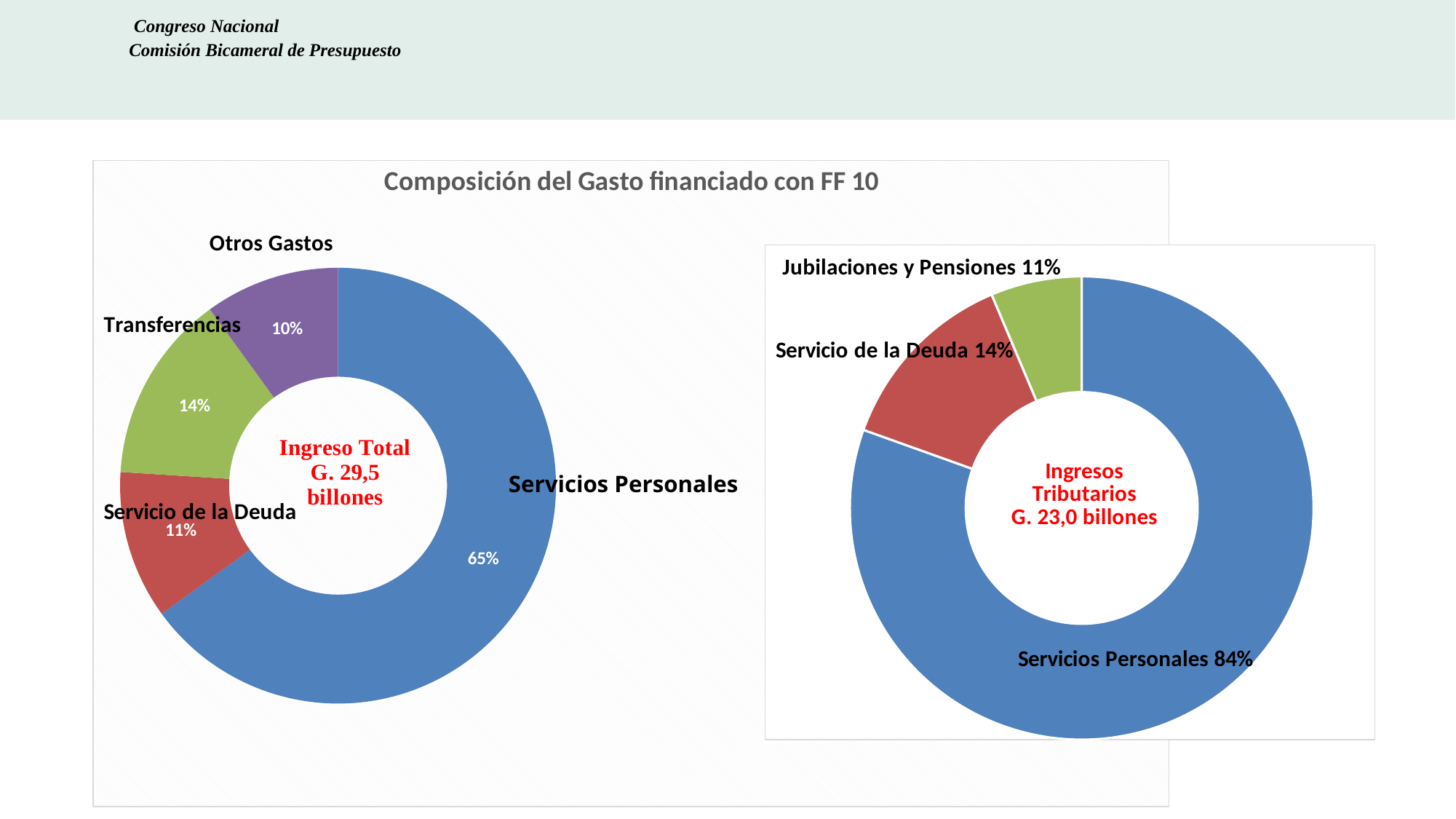
What kind of chart is the right chart (Ingresos Tributarios)? Donut (pie) chart In the left chart titled 'Composición del Gasto financiado con FF 10', how many categories are shown? 4 In the right chart (Ingresos Tributarios), which is larger: Servicio de la Deuda or Jubilaciones y Pensiones? Servicio de la Deuda In the right chart (Ingresos Tributarios), what share does Servicios Personales have? 84% In the left chart titled 'Composición del Gasto financiado con FF 10', what share does Servicios Personales have? 65% In the left chart titled 'Composición del Gasto financiado con FF 10', what share does Transferencias have? 14% In the left chart titled 'Composición del Gasto financiado con FF 10', what is the difference between the shares of Servicios Personales and Servicio de la Deuda? 54 percentage points In the left chart titled 'Composición del Gasto financiado con FF 10', which category has the largest share? Servicios Personales In the left chart titled 'Composición del Gasto financiado con FF 10', what total amount is written in the centre of the donut? Ingreso Total G. 29,5 billones In the left chart titled 'Composición del Gasto financiado con FF 10', which category has the smallest share? Otros Gastos